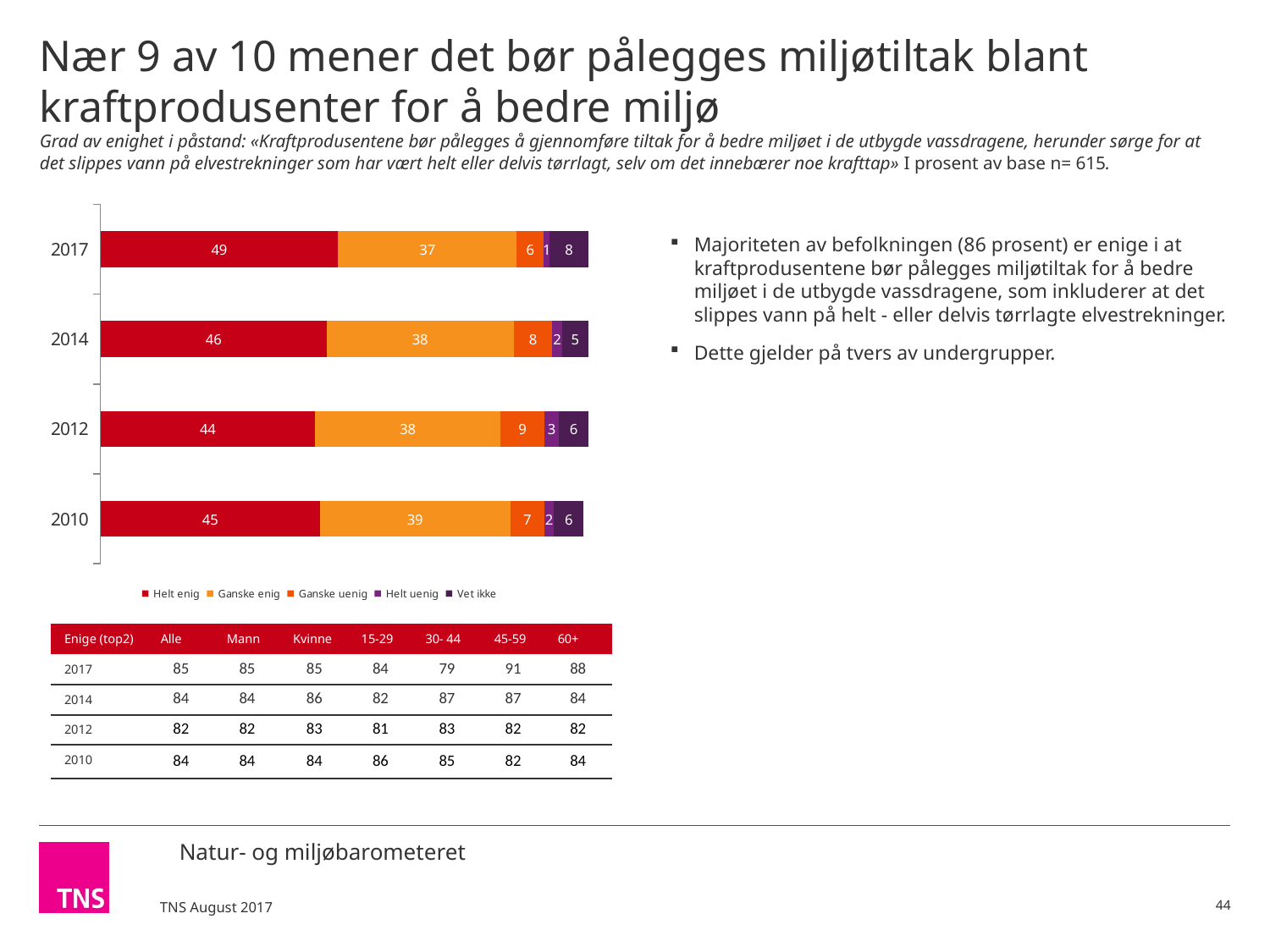
What is the value for 'Ganske enig' in 2010? 39 Which year has the lowest value for 'Helt enig'? 2012 Which is larger: the 'Ganske uenig' value for 2012 or for 2017? 2012 How many years (categories) are plotted in the chart? 4 What kind of chart is shown on the slide? stacked bar chart How many series does the chart legend list? 5 What is the value for 'Helt enig' in 2017? 49 What is the difference between the 'Helt enig' values for 2017 and 2014? 3 What is the value for 'Ganske uenig' in 2012? 9 Which year has the highest value for 'Helt enig'? 2017 What is the total of the stacked bar for 2012? 100 What is the value for 'Vet ikke' in 2014? 5